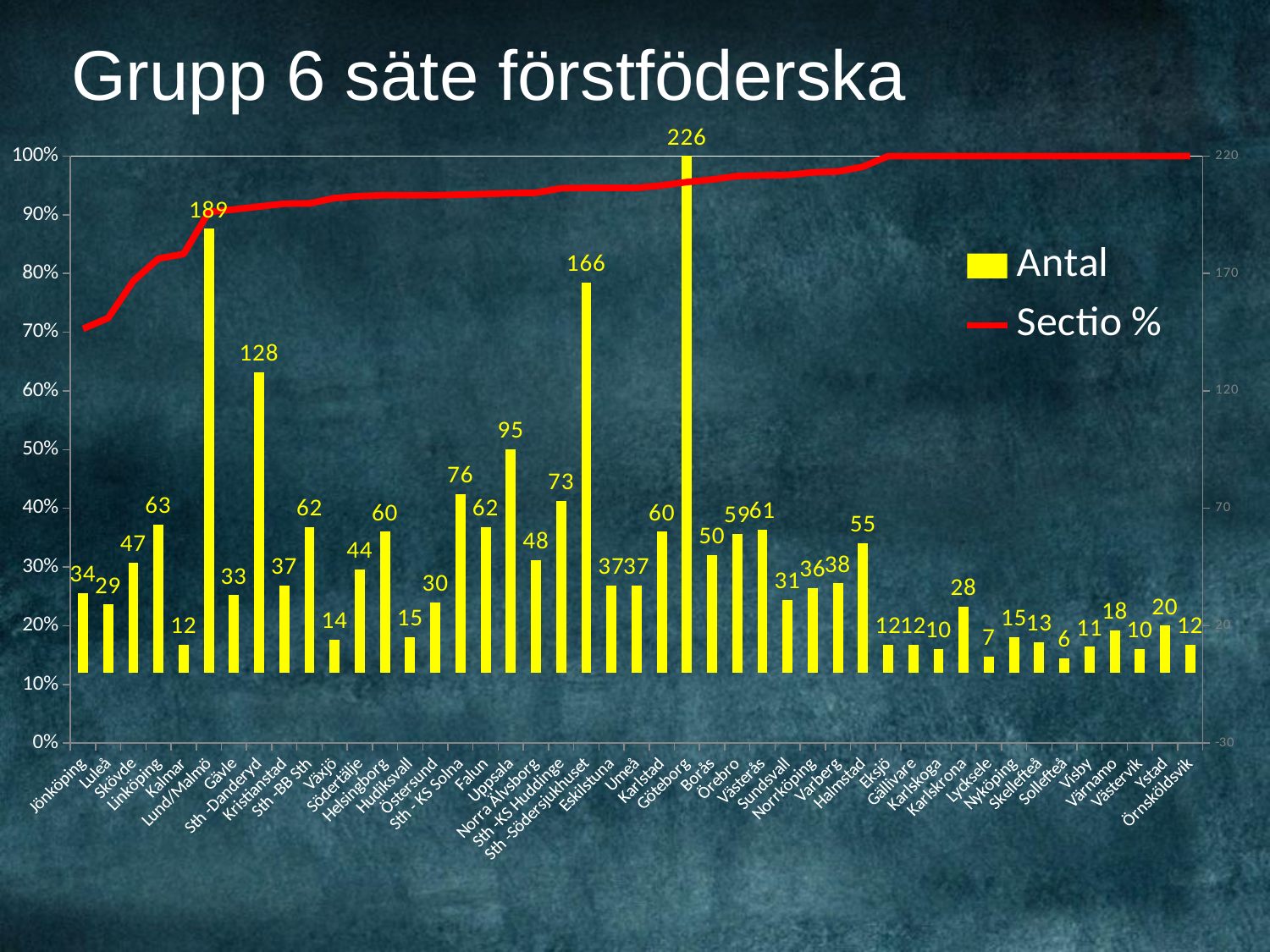
What is the Antal value for Sth -Södersjukhuset? 166 Is the Sectio % value for Jönköping greater or less than 80%? less Which category has the lowest Antal value? Sollefteå What is the title of the slide? Grupp 6 säte förstföderska What is the Antal value for Halmstad? 55 Which category has the highest Antal value? Göteborg Does the Sectio % line rise or fall from left to right along the x axis? rise What is the Antal value for Lund/Malmö? 189 Which has a larger Antal value, Uppsala or Sth -KS Solna? Uppsala How many series does the legend list? 2 Is the Sectio % value for Göteborg greater or less than 90%? greater What is the difference in Antal between Göteborg and Lund/Malmö? 37